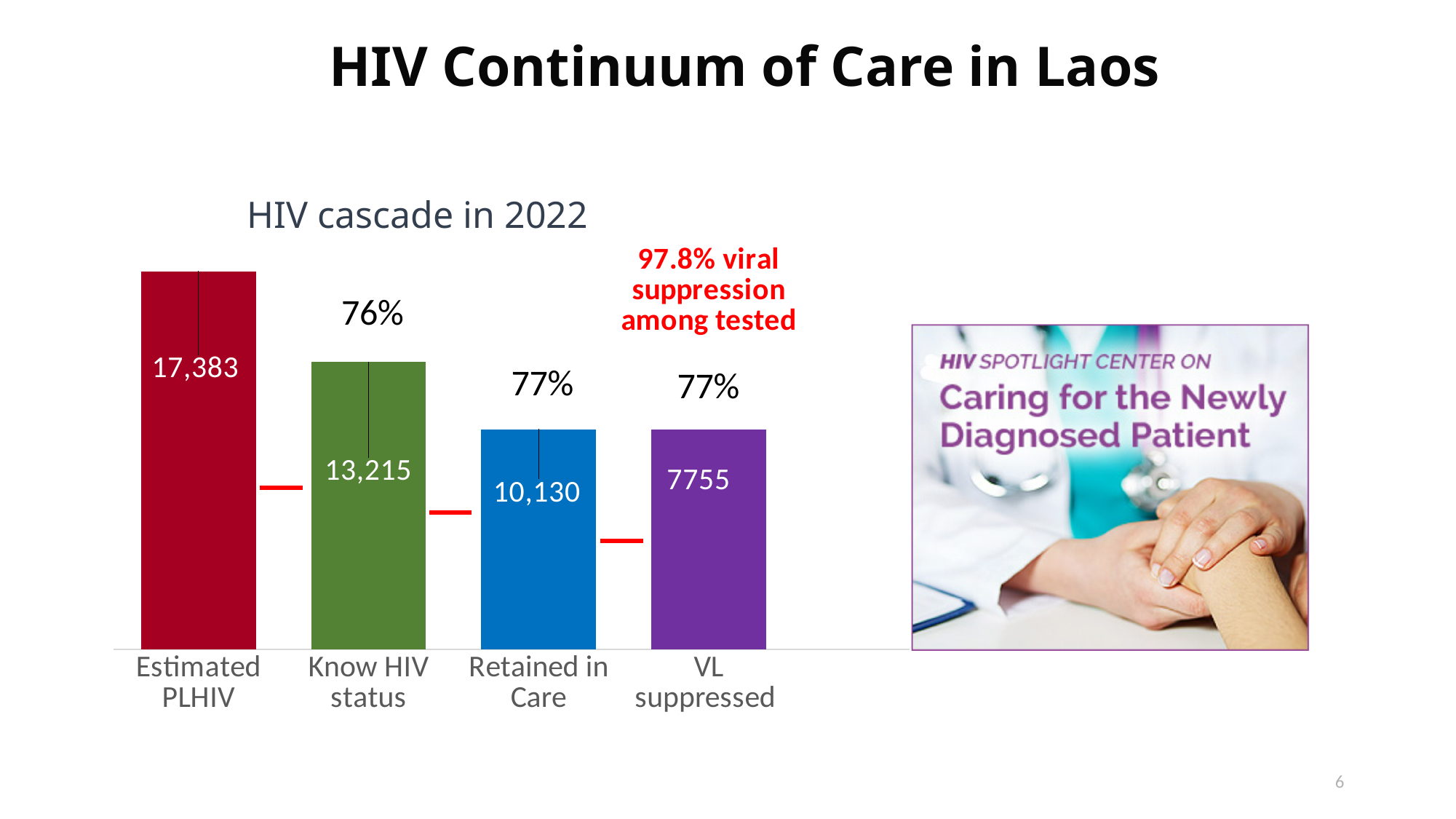
Which category has the lowest value? VL suppressed What kind of chart is this? Bar chart Which category has the highest value? Estimated PLHIV How many categories are shown in the chart? 4 What is the difference between Estimated PLHIV and Know HIV status? 4,168 What is the value for Know HIV status? 13,215 Which is larger, Know HIV status or Retained in Care? Know HIV status What is the value for VL suppressed? 7755 What is the difference between Retained in Care and VL suppressed? 2,375 What is the title of the chart? HIV cascade in 2022 What is the value for Retained in Care? 10,130 What is the value for Estimated PLHIV? 17,383